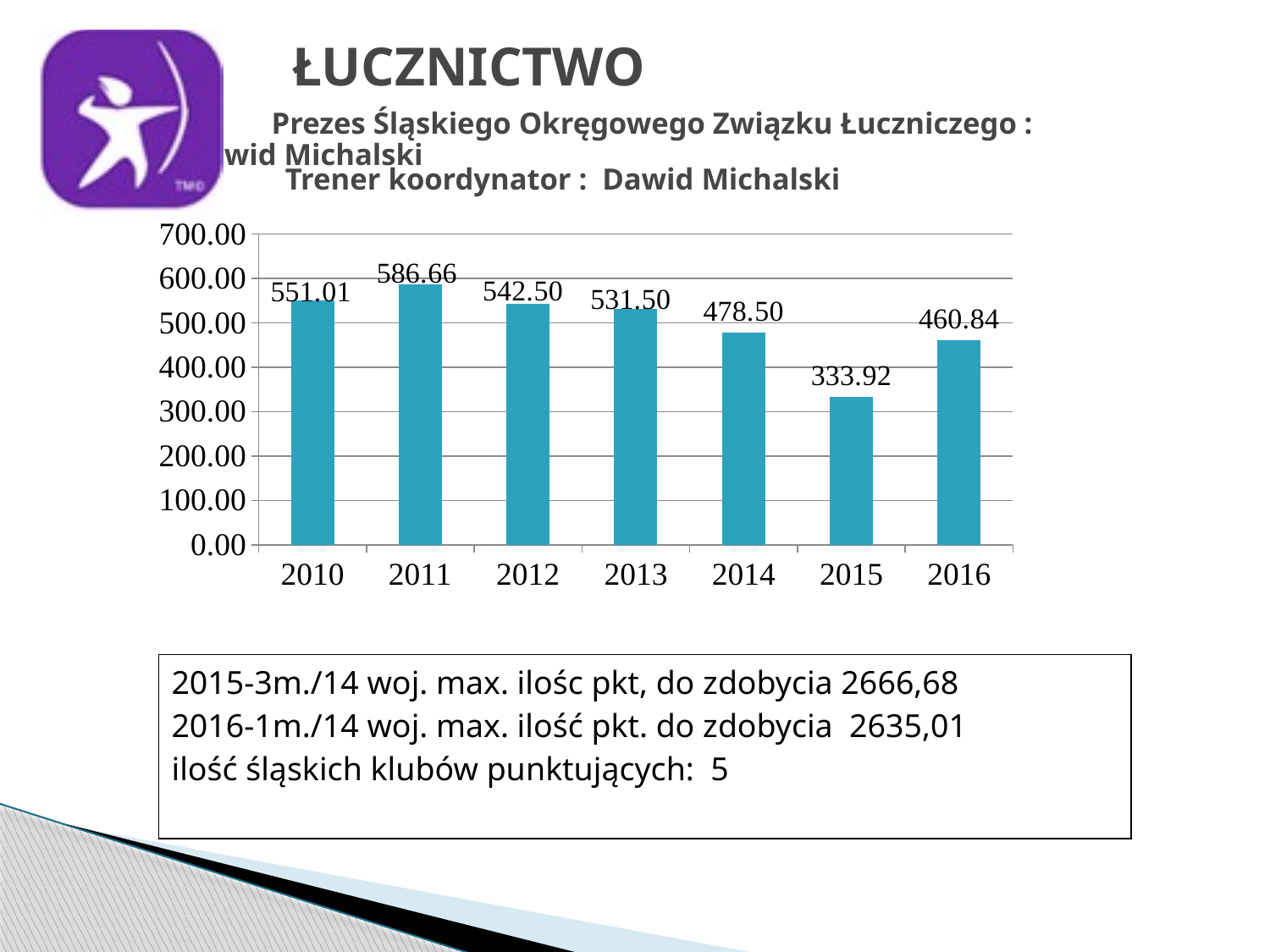
What is the value for 2016? 460.84 What is the difference between the values for 2011 and 2010? 35.65 Which year has the highest value? 2011 What is the difference between the values for 2016 and 2015? 126.92 What is the value for 2011? 586.66 How many years are shown on the x axis? 7 Which year has the lowest value? 2015 What is the value for 2013? 531.50 Which is larger, the value for 2014 or the value for 2016? 2014 What kind of chart is shown on the slide? bar chart Is the value for 2014 greater or less than 500.00? less What is the value for 2015? 333.92